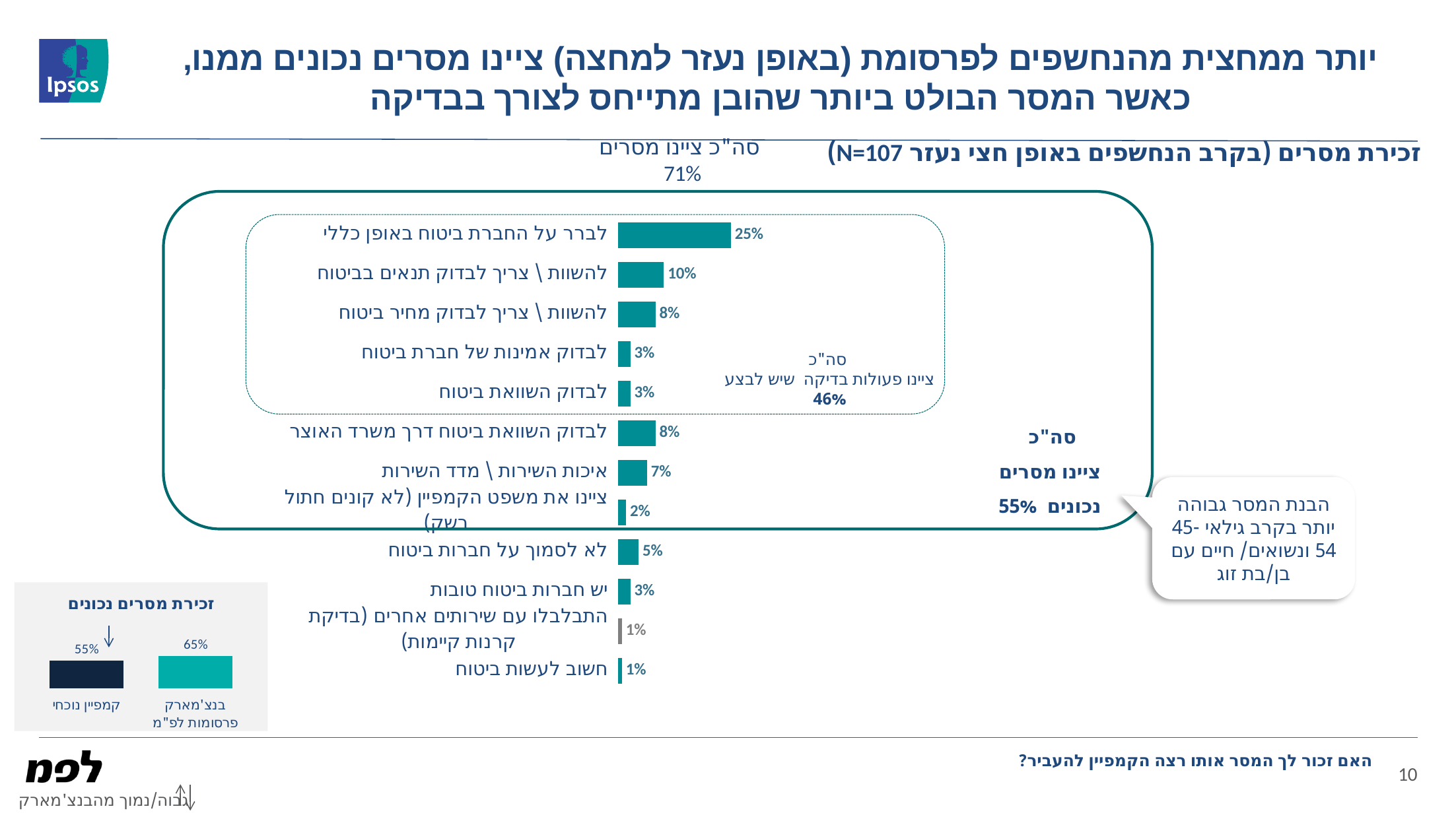
In the main bar chart, what is the value for "איכות השירות \ מדד השירות"? 7% In the main bar chart, what is the difference between "לברר על החברת ביטוח באופן כללי" and "להשוות \ צריך לבדוק תנאים בביטוח"? 15% In the main bar chart, which category has the highest value? לברר על החברת ביטוח באופן כללי In the main bar chart, what is the value for "לברר על החברת ביטוח באופן כללי"? 25% In the small chart at the bottom left ("זכירת מסרים נכונים"), what is the difference between "בנצ'מארק פרסומות לפ"מ" and "קמפיין נוכחי"? 10% In the main bar chart, what is the value for "להשוות \ צריך לבדוק תנאים בביטוח"? 10% In the main bar chart, which is larger: "לא לסמוך על חברות ביטוח" or "יש חברות ביטוח טובות"? לא לסמוך על חברות ביטוח In the small chart at the bottom left ("זכירת מסרים נכונים"), what is the value for "קמפיין נוכחי"? 55% In the small chart at the bottom left ("זכירת מסרים נכונים"), what is the value for "בנצ'מארק פרסומות לפ"מ"? 65% What kind of chart is the main chart on the slide? Bar chart In the main bar chart, what is the value for "חשוב לעשות ביטוח"? 1% How many categories are shown in the main bar chart? 12